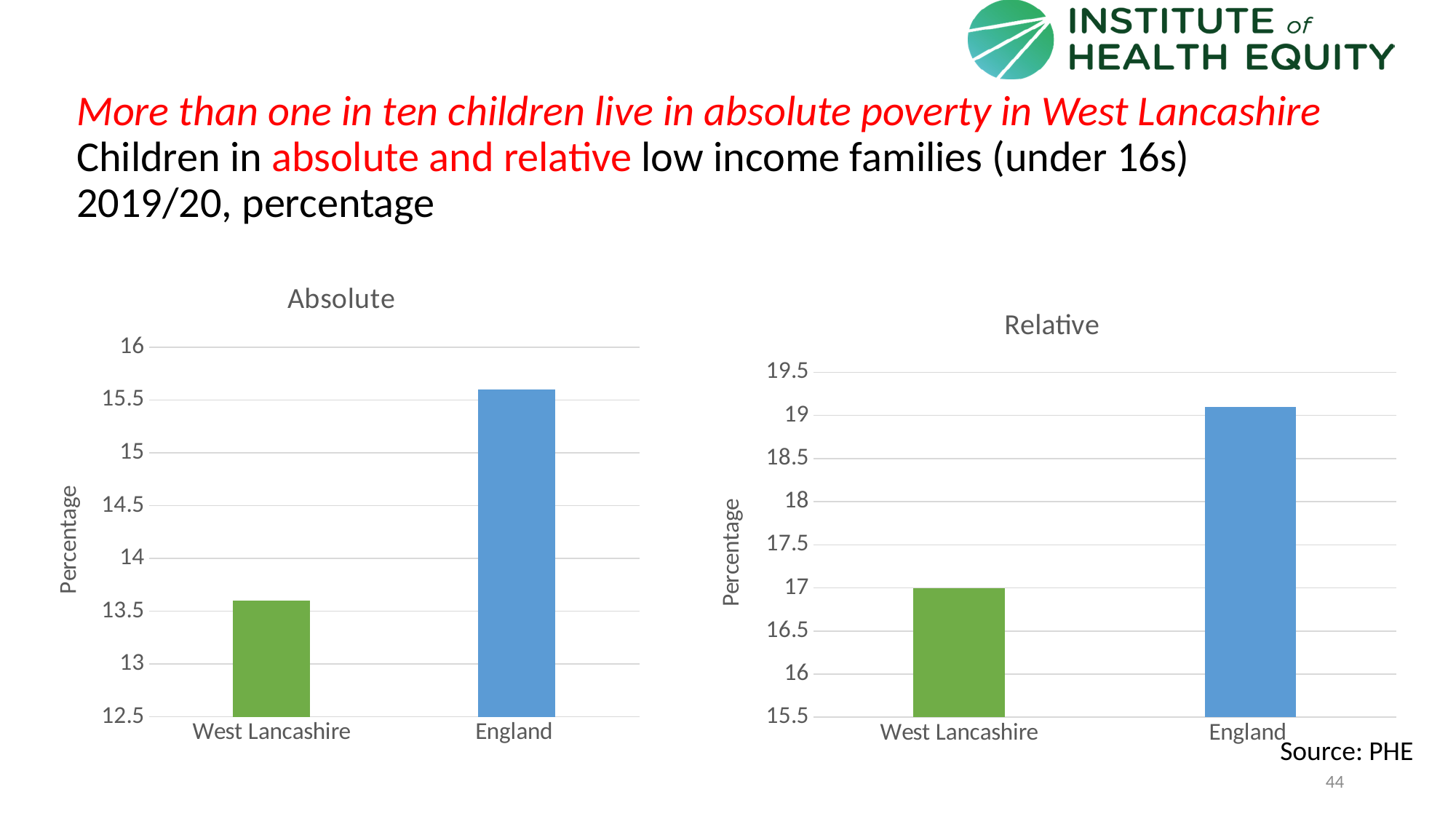
In the Absolute chart, which category has the higher value? England How many categories are shown in the Absolute chart? 2 In the Relative chart, what is the value for West Lancashire? 17 In the Relative chart, which category has the higher value? England In the Absolute chart, is the value for England greater or less than 15? greater What is the y-axis label of the Absolute chart? Percentage In the Relative chart, what colour is the bar for West Lancashire? green In the Relative chart, is the value for West Lancashire greater or less than 18? less In the Relative chart, is the value for England greater or less than 19? greater In the Absolute chart, which category has the lower value? West Lancashire What kind of chart is the Relative chart? bar chart